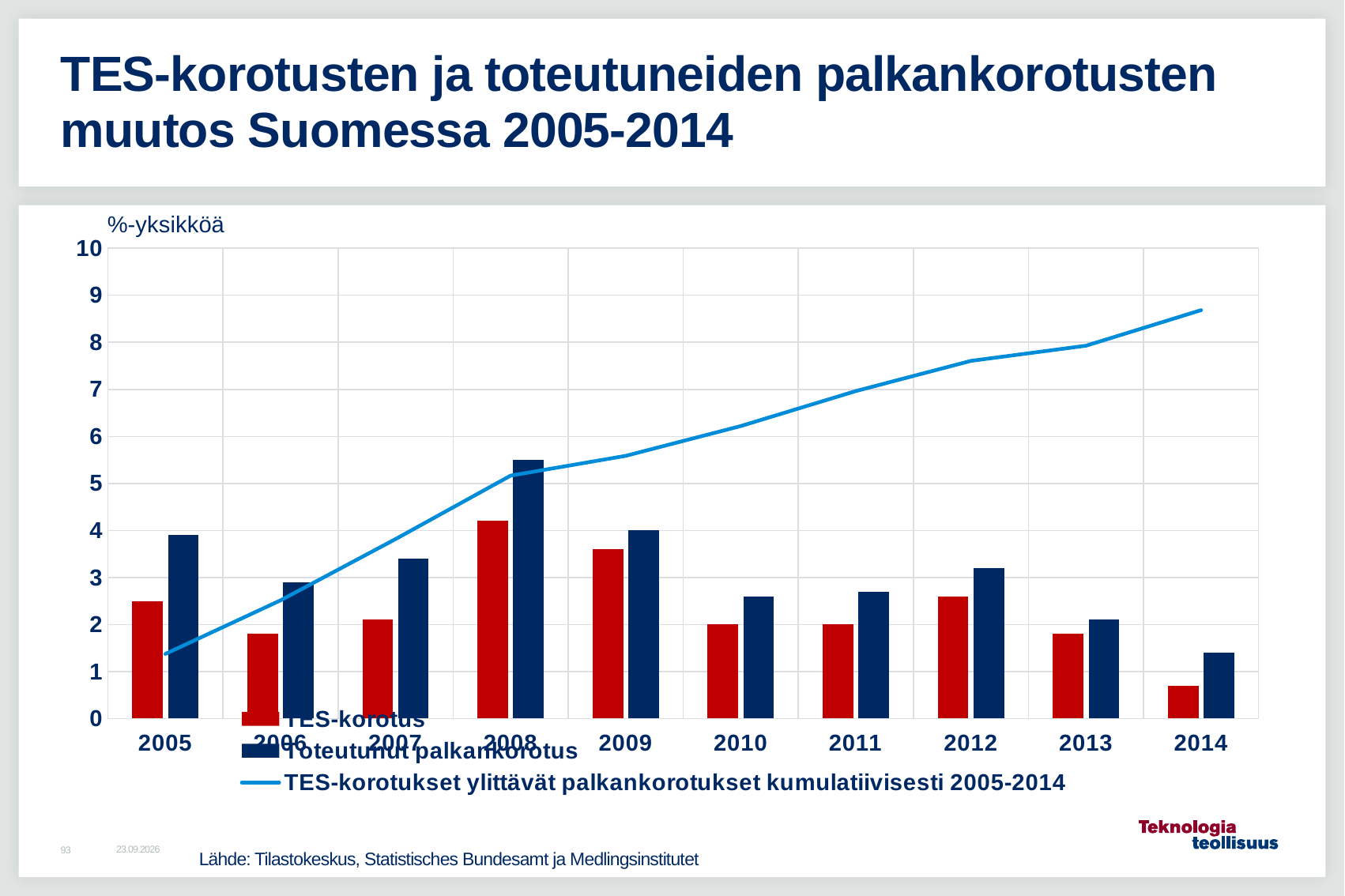
In which year is the Toteutunut palkankorotus bar the highest? 2008 Is the value of the cumulative line (TES-korotukset ylittävät palkankorotukset kumulatiivisesti 2005-2014) in 2014 greater or less than 8? greater In 2005, which is larger: TES-korotus or Toteutunut palkankorotus? Toteutunut palkankorotus How many series does the legend list? 3 In which year is the TES-korotus bar the highest? 2008 Does the cumulative line (TES-korotukset ylittävät palkankorotukset kumulatiivisesti 2005-2014) rise or fall from 2005 to 2014? It rises Is the Toteutunut palkankorotus value for 2008 greater or less than 5? greater In which year is the TES-korotus bar the lowest? 2014 Is the TES-korotus value for 2014 greater or less than 1? less In which year is the Toteutunut palkankorotus bar the lowest? 2014 What kind of chart is shown on the slide? A bar chart combined with a line How many years are shown on the x axis? 10